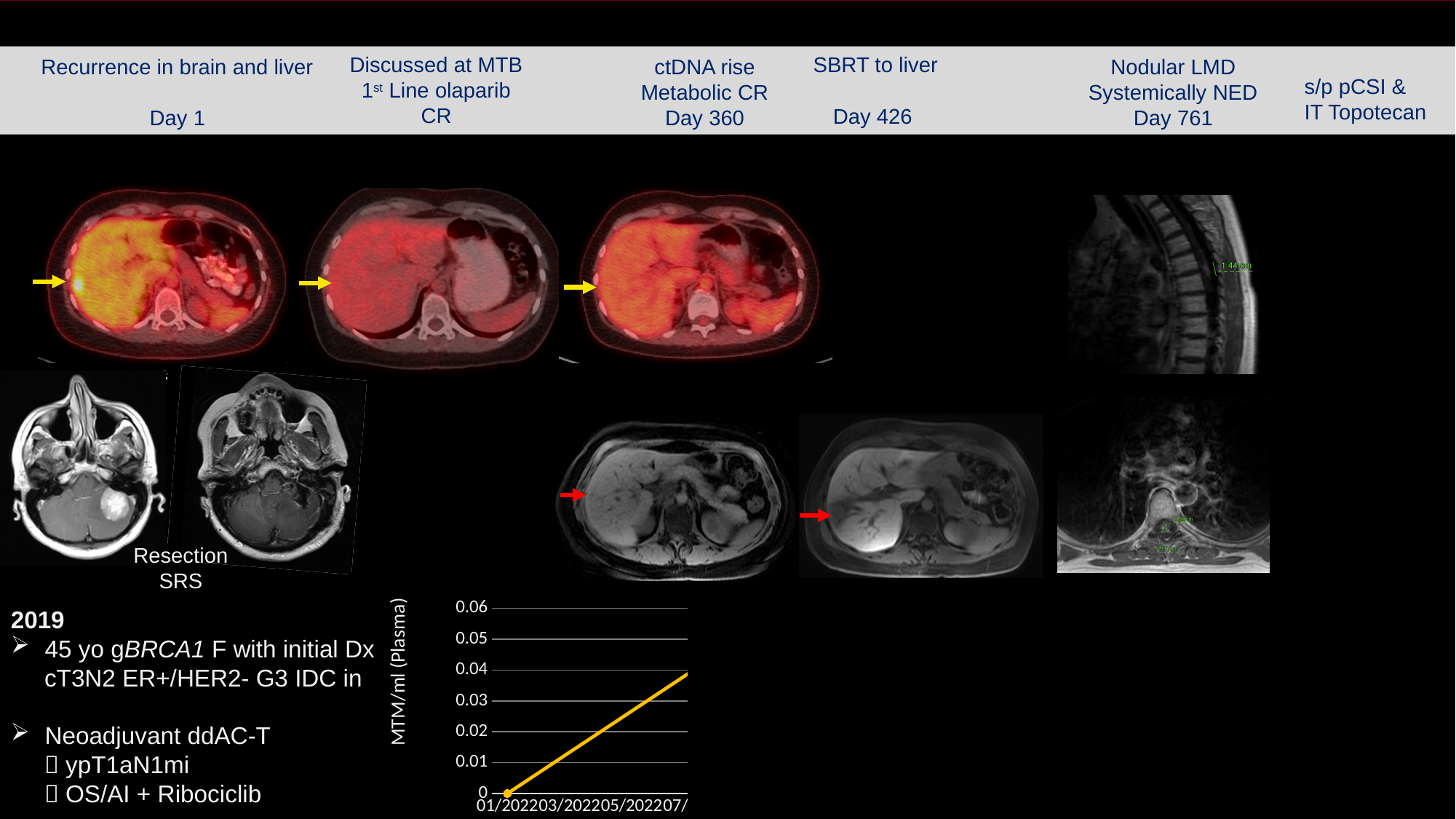
What is the highest tick value shown on the y axis of the line chart? 0.06 How many lines are plotted on the chart? 1 What is the value of the line at 01/2022? 0 Does the plotted line rise or fall from left to right along the x axis? rise Which end of the line is higher, the point at 01/2022 or the point at the right end? the right end Is the value at the right end of the line greater or less than 0.05? less What kind of chart is shown at the bottom of the slide? line chart What is the first date label on the x axis of the line chart? 01/2022 Is the value at the right end of the line greater or less than 0.03? greater What is the label on the y axis of the line chart? MTM/ml (Plasma)